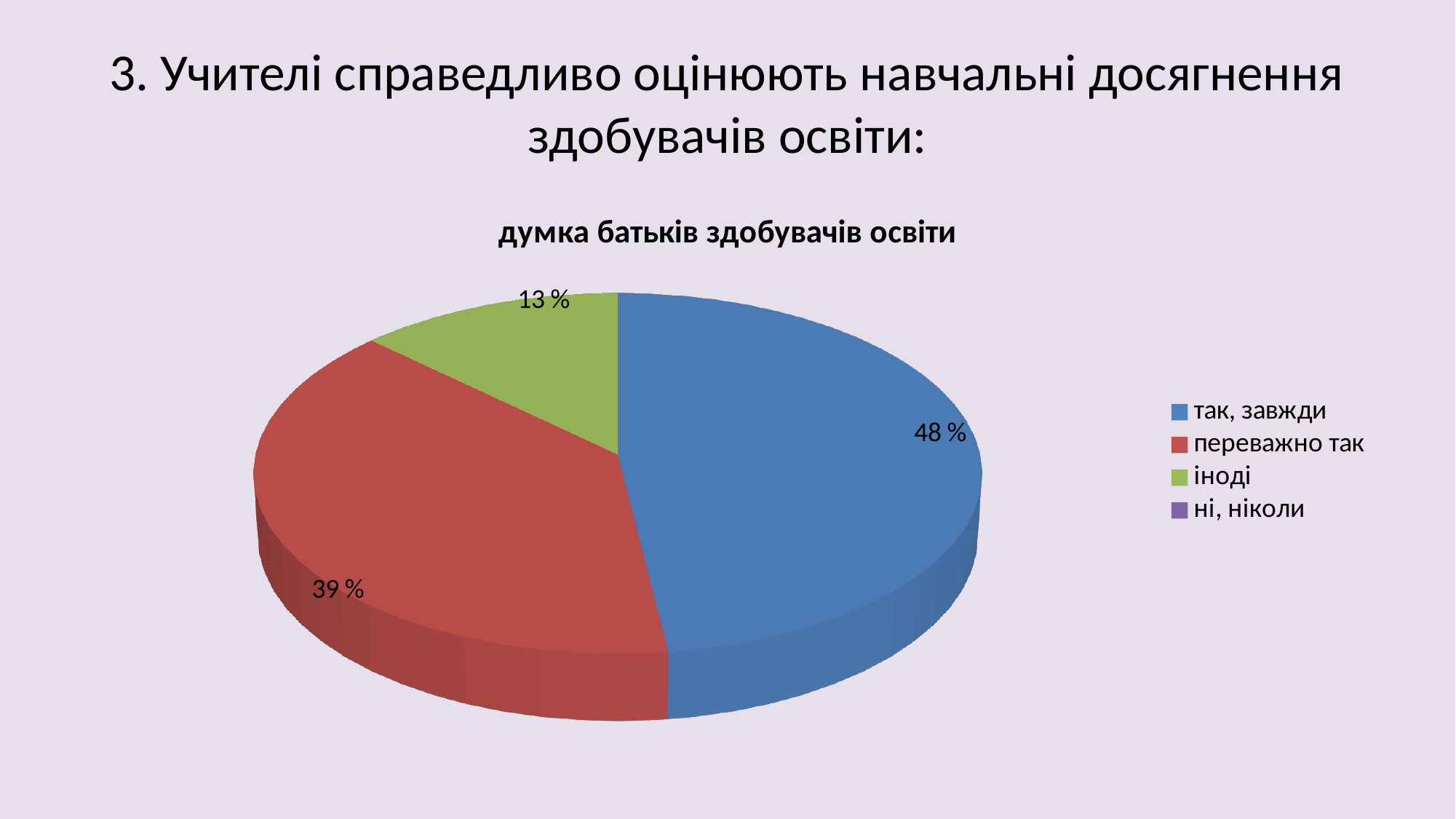
How many entries does the legend list? 4 Which category has the largest slice of the pie? так, завжди What kind of chart is shown on the slide? pie chart What is the difference between the shares for "переважно так" and "іноді"? 26 % What is the title of the chart? думка батьків здобувачів освіти Which of the labelled slices is the smallest? іноді What is the difference between the shares for "так, завжди" and "переважно так"? 9 % Which is larger, the slice for "переважно так" or the slice for "іноді"? переважно так What colour is the slice for "іноді"? green What share of the pie is labelled for "переважно так"? 39 % What share of the pie is labelled for "іноді"? 13 % What share of the pie is labelled for "так, завжди"? 48 %